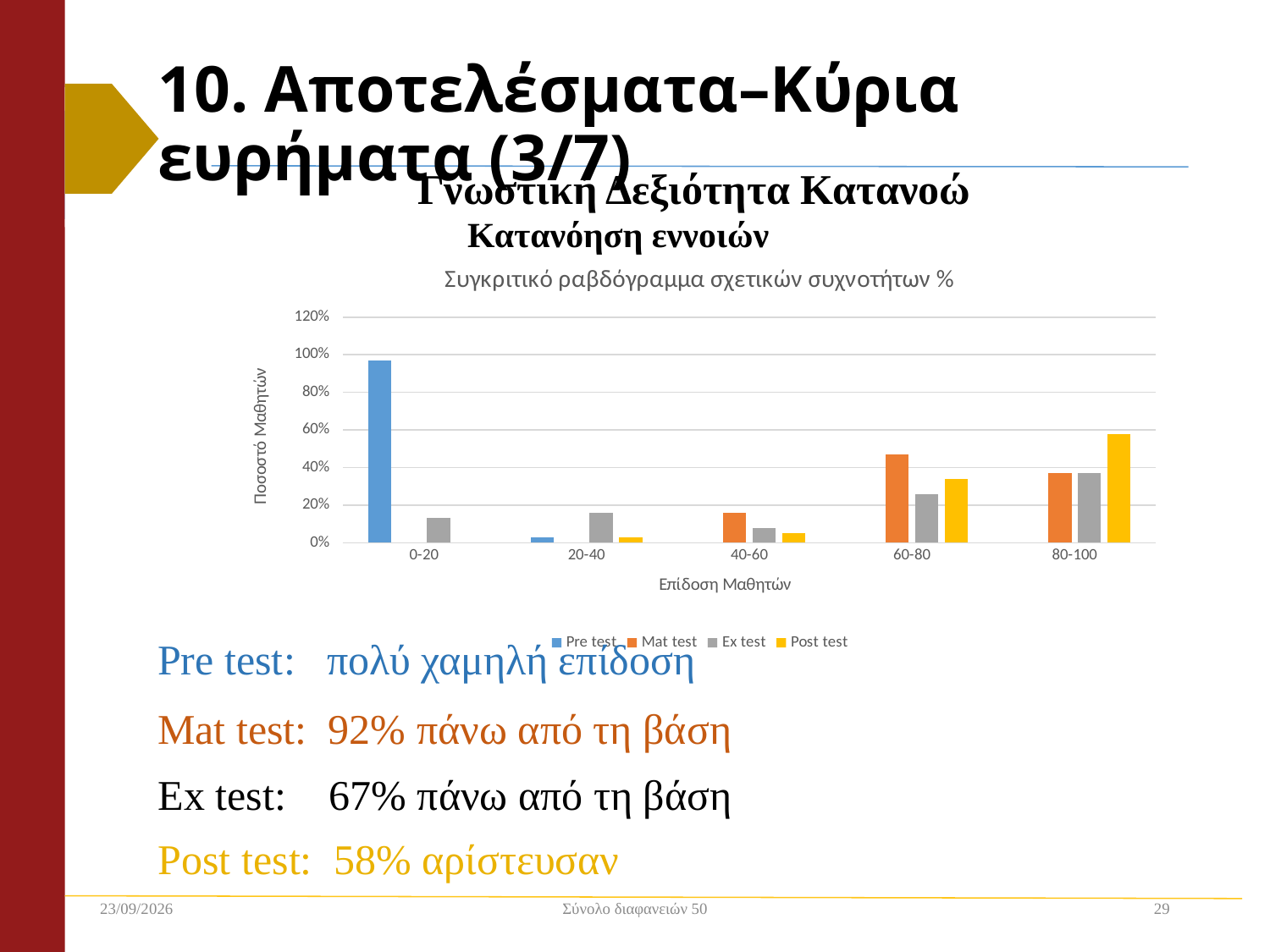
How many score categories are shown on the x axis of the chart? 5 What kind of chart is shown on the slide? bar chart Is the Ex test value for the 60-80 category greater or less than 40%? less In the 60-80 category, which is larger: the Mat test value or the Ex test value? Mat test Which category has the highest Pre test value? 0-20 How many series does the chart legend list? 4 Which category has the highest Post test value? 80-100 What is the title of the x axis of the chart? Επίδοση Μαθητών What are the series names listed in the chart legend? Pre test, Mat test, Ex test, Post test In the 80-100 category, which is larger: the Post test value or the Mat test value? Post test Is the Post test value for the 80-100 category greater or less than 40%? greater Is the Pre test value for the 0-20 category greater or less than 80%? greater